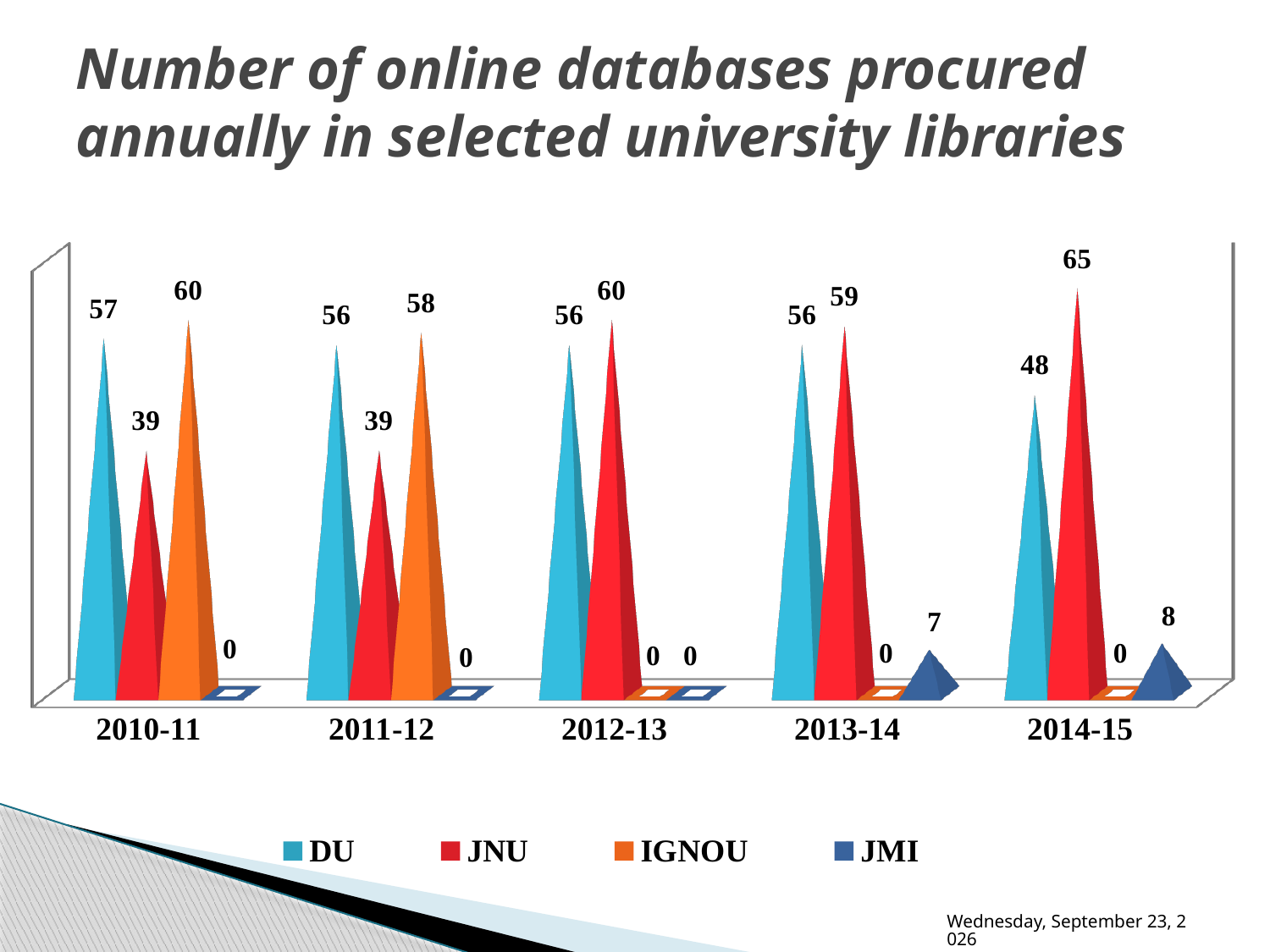
What is the value for JMI in 2013-14? 7 What is the value for DU in 2010-11? 57 How many years are shown on the x axis? 5 Does the DU value rise or fall from 2010-11 to 2014-15? fall In which year is the DU value lowest? 2014-15 What is the difference between the JNU value in 2014-15 and the JNU value in 2010-11? 26 How many series does the legend list? 4 What kind of chart is shown on the slide? bar chart What is the value for JNU in 2014-15? 65 In 2012-13, which is larger, the DU value or the JNU value? JNU In which year is the JNU value highest? 2014-15 What is the value for IGNOU in 2011-12? 58